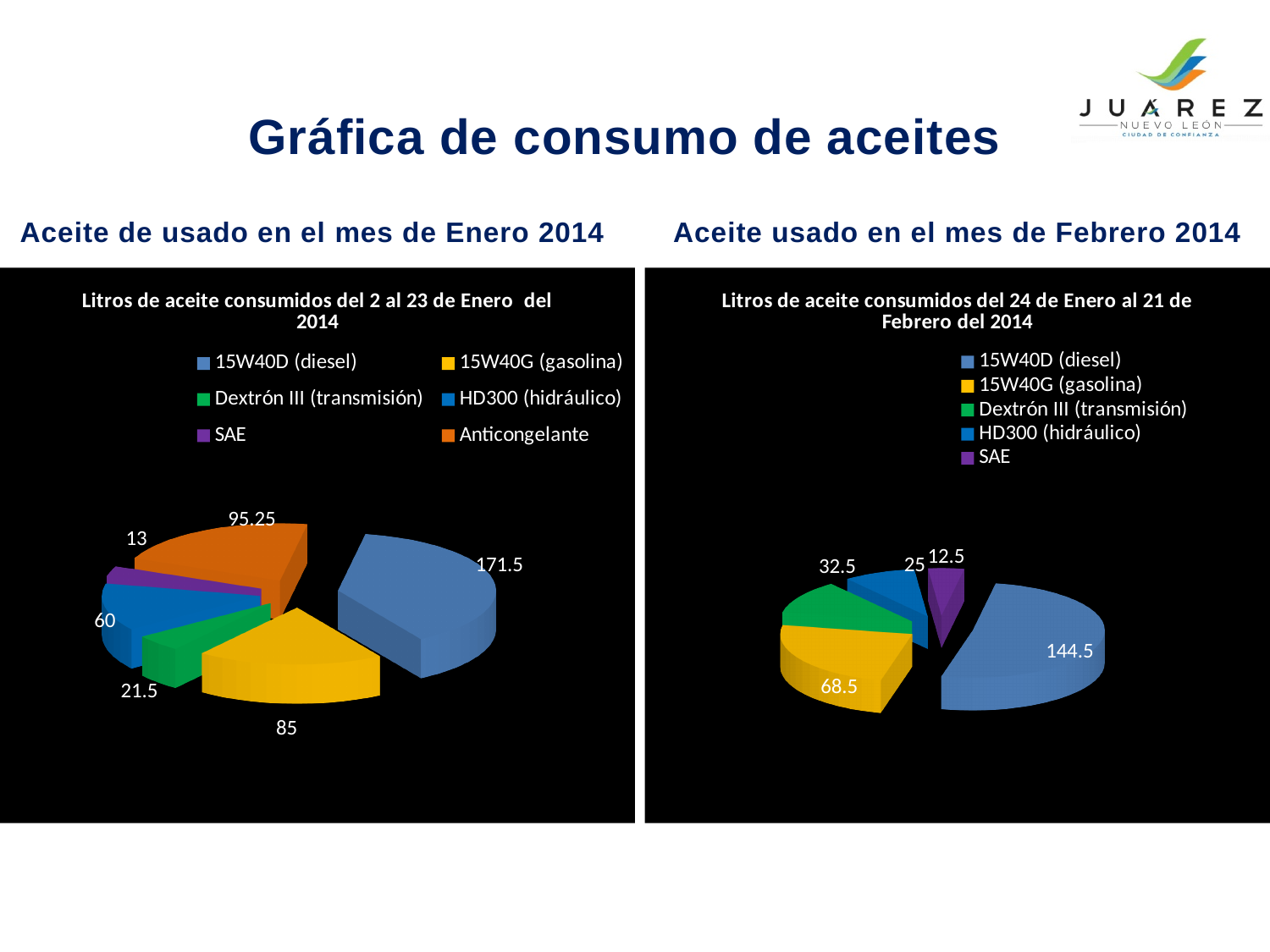
In the chart titled 'Litros de aceite consumidos del 24 de Enero al 21 de Febrero del 2014', which is larger, HD300 (hidráulico) or SAE? HD300 (hidráulico) In the chart titled 'Litros de aceite consumidos del 2 al 23 de Enero del 2014', what is the value for Anticongelante? 95.25 In the chart titled 'Litros de aceite consumidos del 24 de Enero al 21 de Febrero del 2014', what is the difference between 15W40D (diesel) and 15W40G (gasolina)? 76 In the chart titled 'Litros de aceite consumidos del 2 al 23 de Enero del 2014', what is the difference between 15W40G (gasolina) and HD300 (hidráulico)? 25 In the chart titled 'Litros de aceite consumidos del 24 de Enero al 21 de Febrero del 2014', what is the value for 15W40G (gasolina)? 68.5 In the chart titled 'Litros de aceite consumidos del 24 de Enero al 21 de Febrero del 2014', what is the value for Dextrón III (transmisión)? 32.5 In the chart titled 'Litros de aceite consumidos del 2 al 23 de Enero del 2014', how many categories does the legend list? 6 In the chart titled 'Litros de aceite consumidos del 24 de Enero al 21 de Febrero del 2014', which category has the highest value? 15W40D (diesel) What kind of chart is the one on the right side of the slide? Pie chart In the chart titled 'Litros de aceite consumidos del 2 al 23 de Enero del 2014', which category has the lowest value? SAE In the chart titled 'Litros de aceite consumidos del 2 al 23 de Enero del 2014', what is the value for 15W40D (diesel)? 171.5 Which category appears in the legend of the left chart but not in the legend of the right chart? Anticongelante